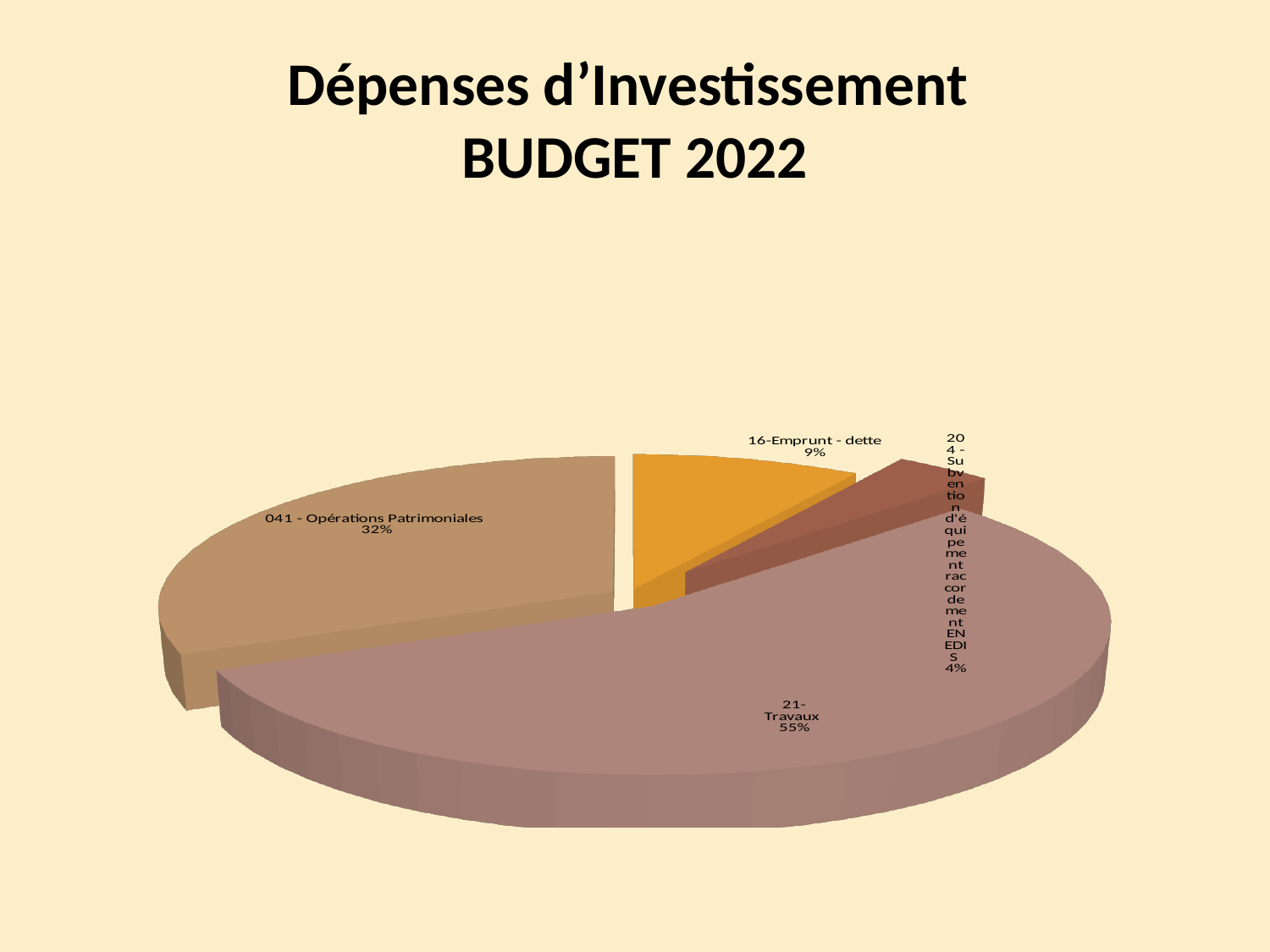
Which is larger, the share for 16-Emprunt - dette or the share for 041 - Opérations Patrimoniales? 041 - Opérations Patrimoniales Which category has the smallest slice of the pie? 204 - Subvention d'équipement raccordement ENEDIS What share of the pie does 16-Emprunt - dette represent? 9% What share of the pie does 041 - Opérations Patrimoniales represent? 32% What is the difference in percentage points between 16-Emprunt - dette and 204 - Subvention d'équipement raccordement ENEDIS? 5 percentage points What share of the pie does 21-Travaux represent? 55% What is the title of the slide containing the pie chart? Dépenses d'Investissement BUDGET 2022 What is the difference in percentage points between 21-Travaux and 041 - Opérations Patrimoniales? 23 percentage points What kind of chart is shown on the slide? Pie chart Which category has the largest slice of the pie? 21-Travaux How many slices does the pie chart have? 4